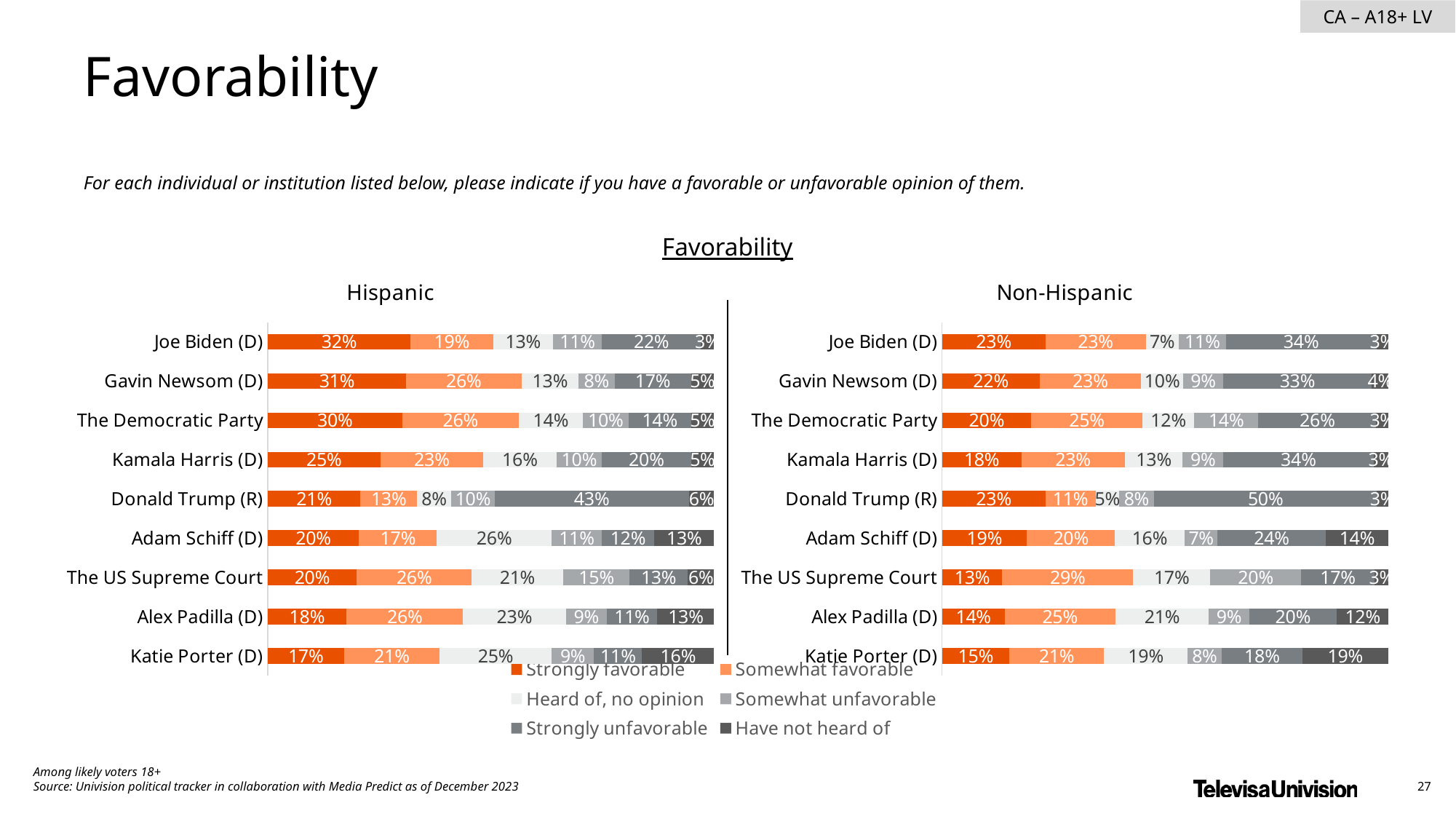
In the Hispanic chart, what percentage of respondents are strongly favorable toward Joe Biden (D)? 32% In the Non-Hispanic chart, which individual or institution has the lowest strongly favorable percentage? The US Supreme Court In the Hispanic chart, which individual or institution has the highest strongly unfavorable percentage? Donald Trump (R) In the Non-Hispanic chart, what is the combined strongly favorable and somewhat favorable percentage for Joe Biden (D)? 46% In the Hispanic chart, what is the difference between the strongly favorable percentages for Joe Biden (D) and Katie Porter (D)? 15% In the Non-Hispanic chart, is the somewhat favorable percentage larger for The US Supreme Court or for Alex Padilla (D)? The US Supreme Court How many individuals or institutions are listed in the Hispanic chart? 9 What type of chart is used to show favorability for the Hispanic and Non-Hispanic groups? Stacked bar chart In the Non-Hispanic chart, what percentage of respondents are strongly unfavorable toward Donald Trump (R)? 50% In the Hispanic chart, what percentage of respondents have not heard of Katie Porter (D)? 16% Which legend entry is shown in the darkest orange colour? Strongly favorable How many series does the legend list for the favorability charts? 6